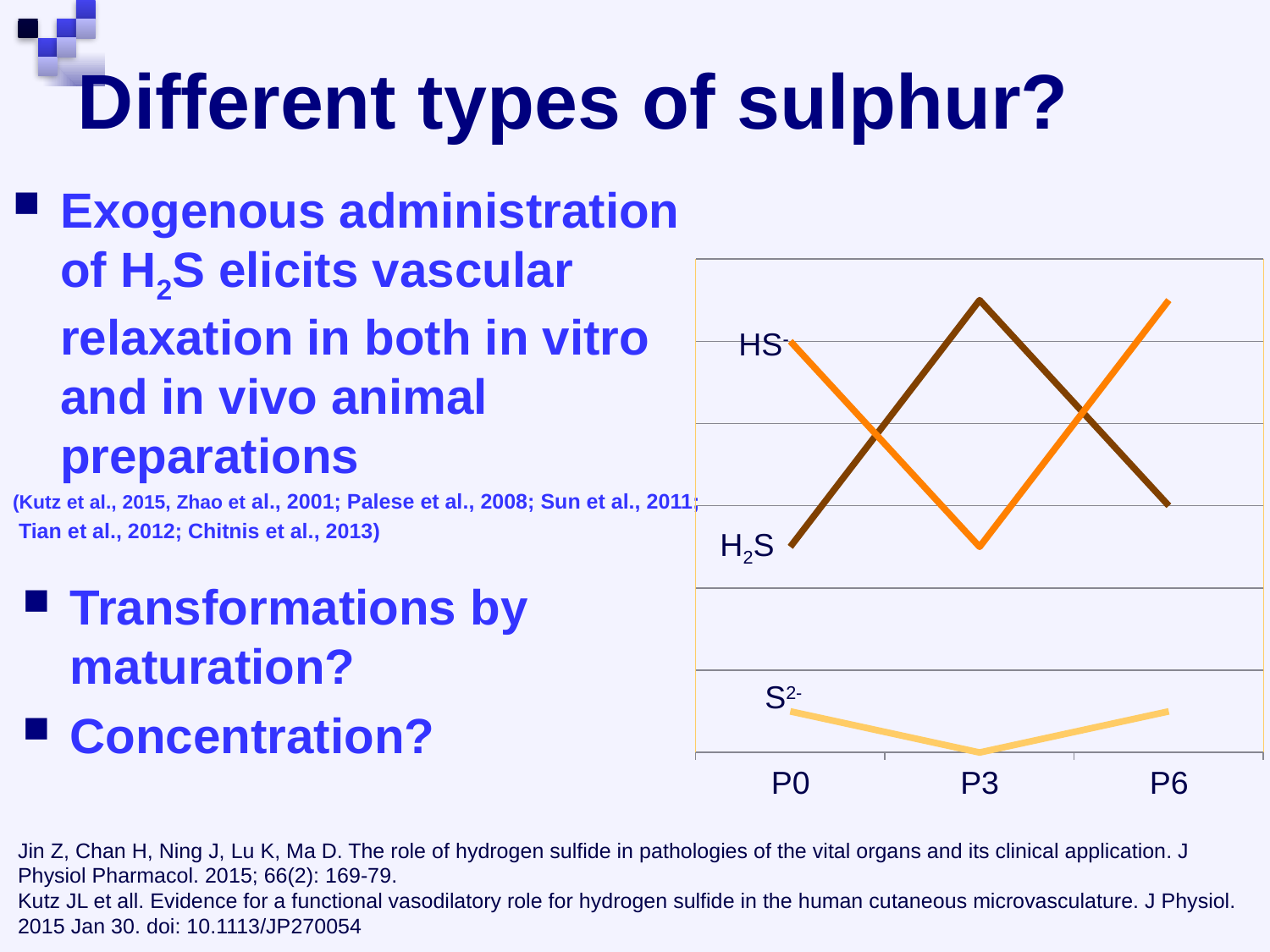
Does the H2S line rise or fall from P0 to P3? rise How many points are on the x axis of the chart? 3 How many series are plotted in the chart? 3 Does the HS- line rise or fall from P0 to P3? fall What are the x-axis labels of the chart? P0, P3, P6 At P6, which is higher, HS- or H2S? HS- Which series is highest at P0? HS- What kind of chart is shown on the slide? line chart Which series is lowest at P0? S2- Does the H2S line rise or fall from P3 to P6? fall Which series is highest at P3? H2S At P3, which is higher, HS- or H2S? H2S